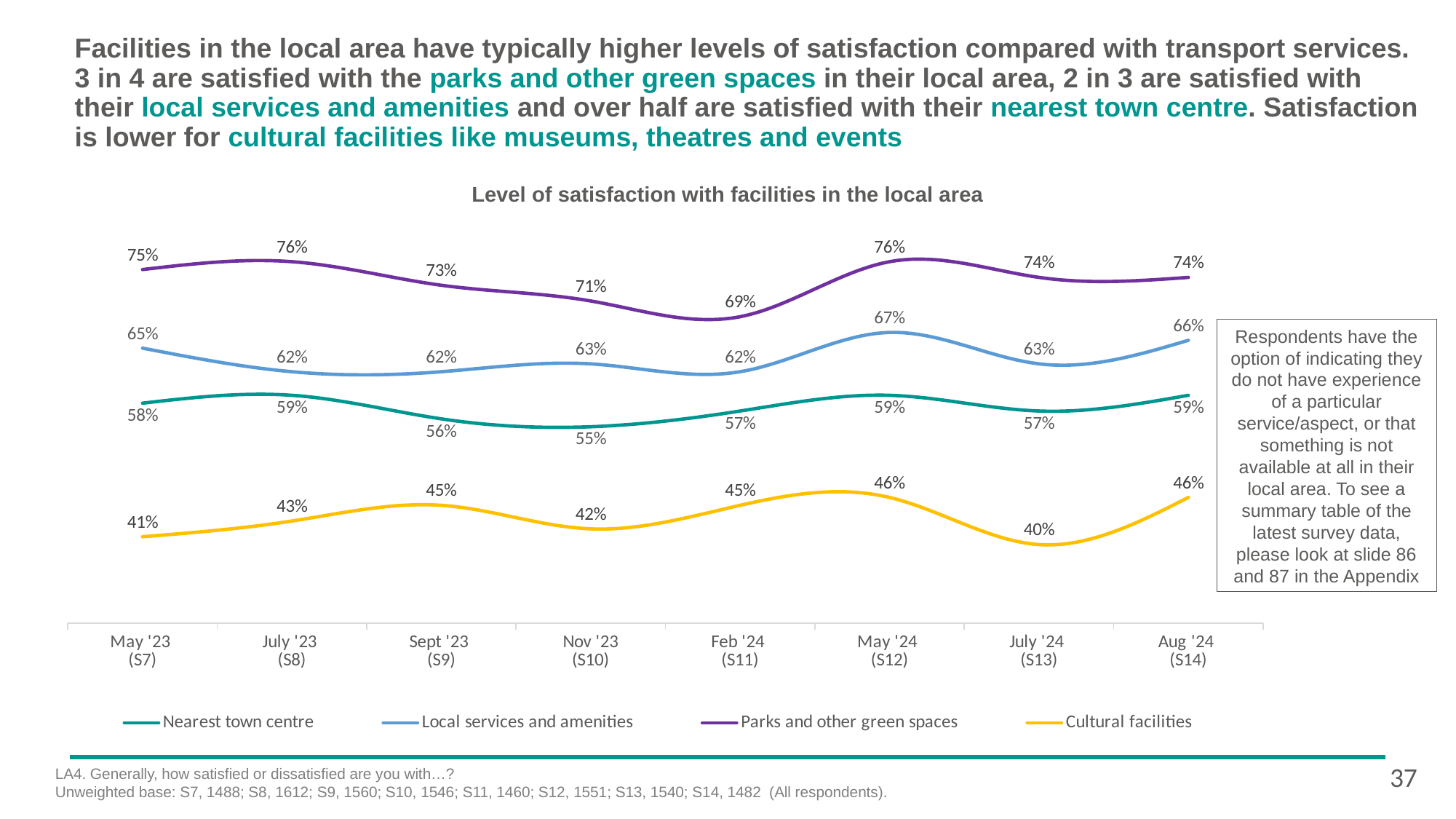
What is the title of the chart? Level of satisfaction with facilities in the local area How many survey waves are shown on the x axis? 8 What kind of chart is shown on the slide? Line chart What is the satisfaction level for Parks and other green spaces in Feb '24 (S11)? 69% What is the satisfaction level for Local services and amenities in May '24 (S12)? 67% What is the satisfaction level for Nearest town centre in Nov '23 (S10)? 55% What is the satisfaction level for Cultural facilities in July '24 (S13)? 40% Which series has the highest satisfaction level in Aug '24 (S14)? Parks and other green spaces How many series does the legend list? 4 What is the difference between the Parks and other green spaces value and the Cultural facilities value in May '23 (S7)? 34 percentage points Which is larger in Sept '23 (S9): Local services and amenities or Nearest town centre? Local services and amenities In which survey wave is satisfaction with Cultural facilities lowest? July '24 (S13)